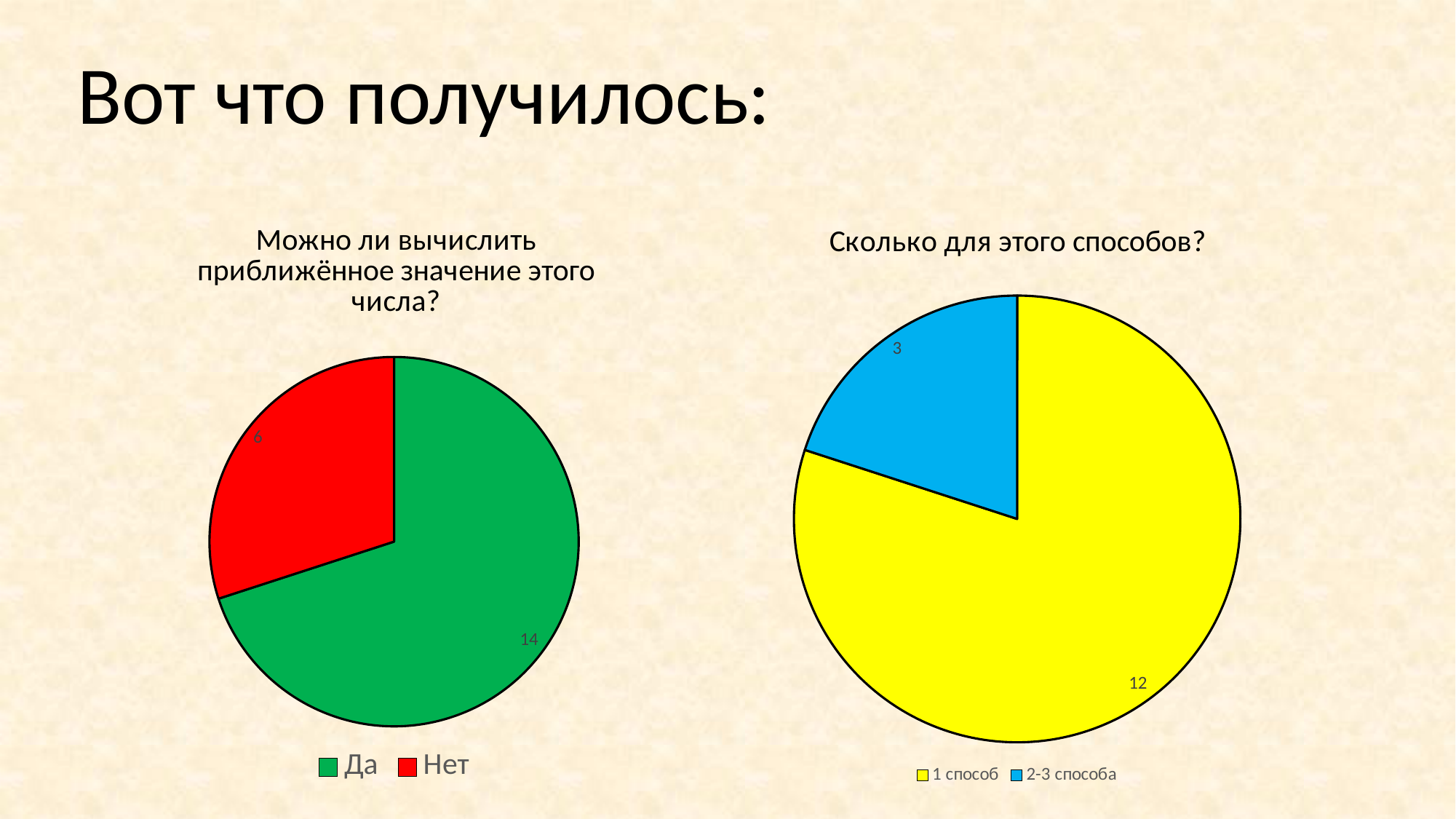
In the right chart "Сколько для этого способов?", what is the value for "1 способ"? 12 In the left chart "Можно ли вычислить приближённое значение этого числа?", which category has the largest slice? Да In the left chart "Можно ли вычислить приближённое значение этого числа?", what is the difference between the values for "Да" and "Нет"? 8 What type of chart is the right chart "Сколько для этого способов?"? Pie chart In the left chart "Можно ли вычислить приближённое значение этого числа?", what colour is the "Нет" slice? Red In the right chart "Сколько для этого способов?", which category has the smallest slice? 2-3 способа In the right chart "Сколько для этого способов?", what share of the pie does "2-3 способа" represent? 20% In the left chart "Можно ли вычислить приближённое значение этого числа?", what share of the pie does "Да" represent? 70% In the left chart "Можно ли вычислить приближённое значение этого числа?", what is the value for "Нет"? 6 In the left chart "Можно ли вычислить приближённое значение этого числа?", what is the value for "Да"? 14 In the right chart "Сколько для этого способов?", what is the difference between the values for "1 способ" and "2-3 способа"? 9 In the right chart "Сколько для этого способов?", what is the value for "2-3 способа"? 3